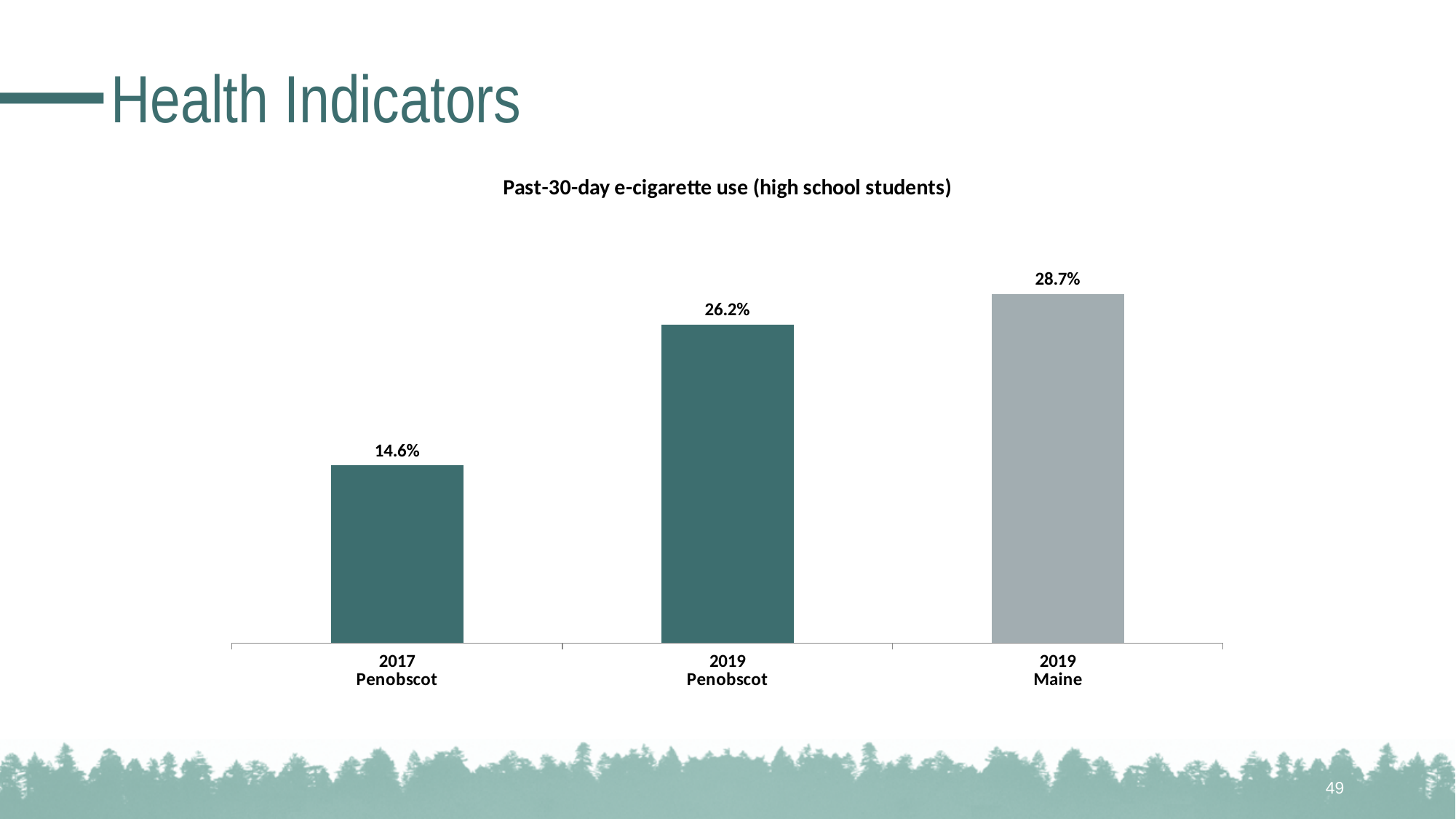
Which category has the lowest value? 2017 Penobscot Do the values rise or fall from left to right across the chart? Rise What is the title of the chart? Past-30-day e-cigarette use (high school students) What is the value for 2019 Maine? 28.7% What is the difference between the 2019 Penobscot and 2017 Penobscot values? 11.6% What is the value for 2017 Penobscot? 14.6% Which category has the highest value? 2019 Maine Which is larger, the value for 2019 Penobscot or 2019 Maine? 2019 Maine What is the difference between the 2019 Maine and 2019 Penobscot values? 2.5% What kind of chart is shown on the slide? Bar chart What is the value for 2019 Penobscot? 26.2% How many categories are shown in the chart? 3